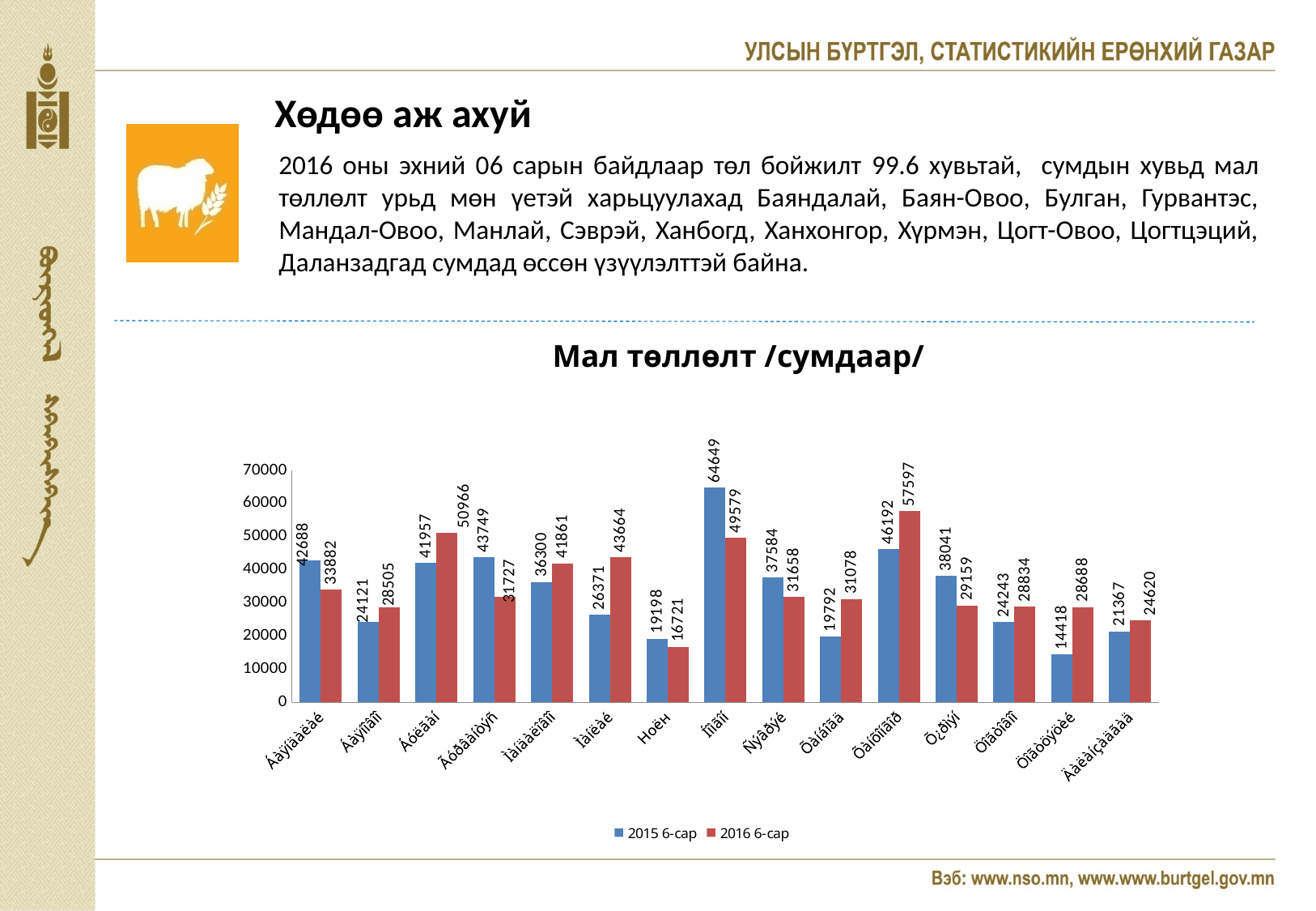
How many categories are plotted along the x axis of the chart? 15 What is the 2015 6-сар value for Ноён? 19198 For Ноён, which series has the larger value, 2015 6-сар or 2016 6-сар? 2015 6-сар What is the 2016 6-сар value for Ноён? 16721 Which category has the lowest 2016 6-сар value? Ноён What is the highest value shown for the 2016 6-сар series? 57597 How many series does the legend of the chart list? 2 What is the lowest value shown for the 2015 6-сар series? 14418 What is the title of the chart? Мал төллөлт /сумдаар/ What is the highest value shown for the 2015 6-сар series? 64649 What is the difference between the 2015 6-сар and 2016 6-сар values for Ноён? 2477 What kind of chart is shown on the slide? bar chart